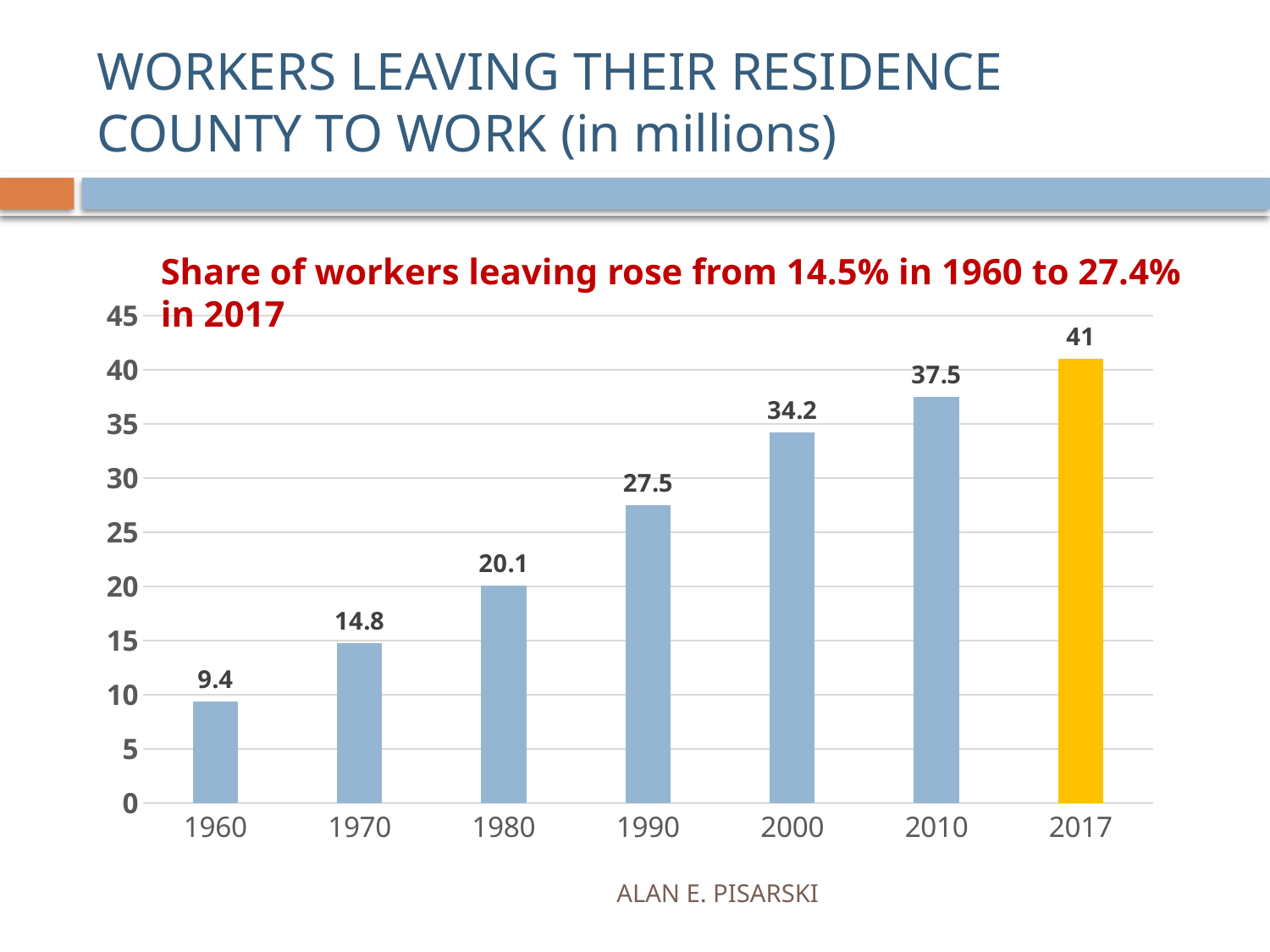
Which year has the lowest value? 1960 What is the difference between the values for 2017 and 1960? 31.6 What is the value for 1960? 9.4 What is the value for 2017? 41 What kind of chart is shown? bar chart How many years are shown on the x axis? 7 Is the value for 2000 greater or less than 30? greater What is the difference between the values for 2010 and 2000? 3.3 Do the values rise or fall from 1960 to 2017? rise Which year has the highest value? 2017 What is the value for 1990? 27.5 Which is larger, the value for 1980 or the value for 1970? 1980